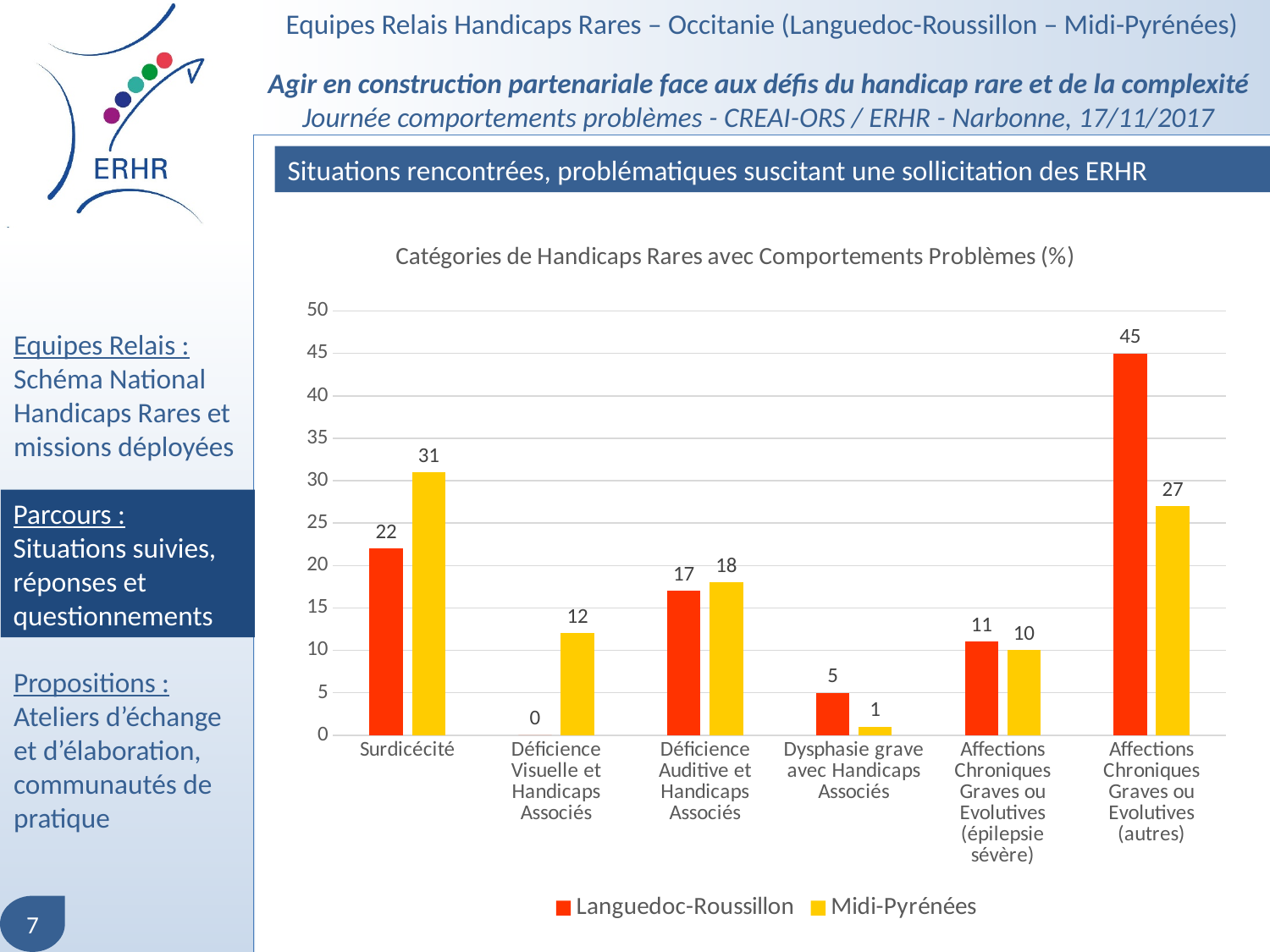
In the Surdicécité category, which series has the larger value, Languedoc-Roussillon or Midi-Pyrénées? Midi-Pyrénées What is the value for Languedoc-Roussillon in the Dysphasie grave avec Handicaps Associés category? 5 What is the value for Languedoc-Roussillon in the Surdicécité category? 22 What is the title of the chart? Catégories de Handicaps Rares avec Comportements Problèmes (%) Is the value for Languedoc-Roussillon in the Affections Chroniques Graves ou Evolutives (autres) category greater or less than 40? greater How many series does the legend list? 2 Which category has the lowest value for Midi-Pyrénées? Dysphasie grave avec Handicaps Associés How many categories are shown on the x axis? 6 What is the value for Midi-Pyrénées in the Déficience Visuelle et Handicaps Associés category? 12 What is the difference between Languedoc-Roussillon and Midi-Pyrénées in the Affections Chroniques Graves ou Evolutives (autres) category? 18 What kind of chart is shown on the slide? bar chart Which category has the highest value for Languedoc-Roussillon? Affections Chroniques Graves ou Evolutives (autres)